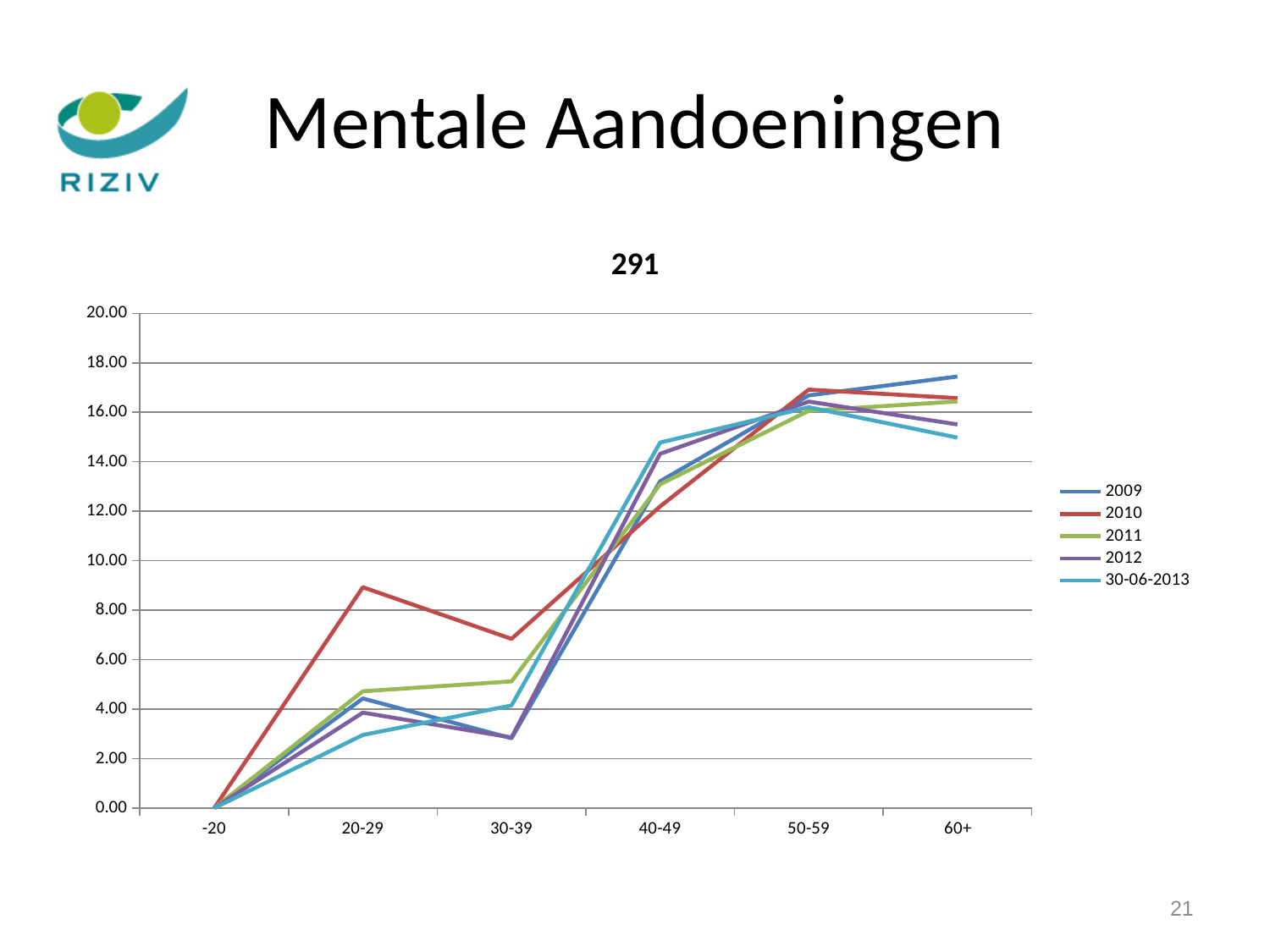
What is the title of the chart? 291 What is the value for the 2010 series at the -20 category? 0.00 Which series has the highest value at the 60+ category? 2009 How many age categories are shown on the x axis? 6 At the 60+ category, which is larger: the value for 2009 or the value for 30-06-2013? 2009 What is the last entry in the legend? 30-06-2013 How many series does the legend list? 5 Is the value for 2012 at 30-39 greater or less than 4.00? less Does the 2010 series rise or fall from 50-59 to 60+? fall Is the value for 2010 at 20-29 greater or less than 8.00? greater What kind of chart is shown on the slide? line chart Which series has the highest value at the 20-29 category? 2010